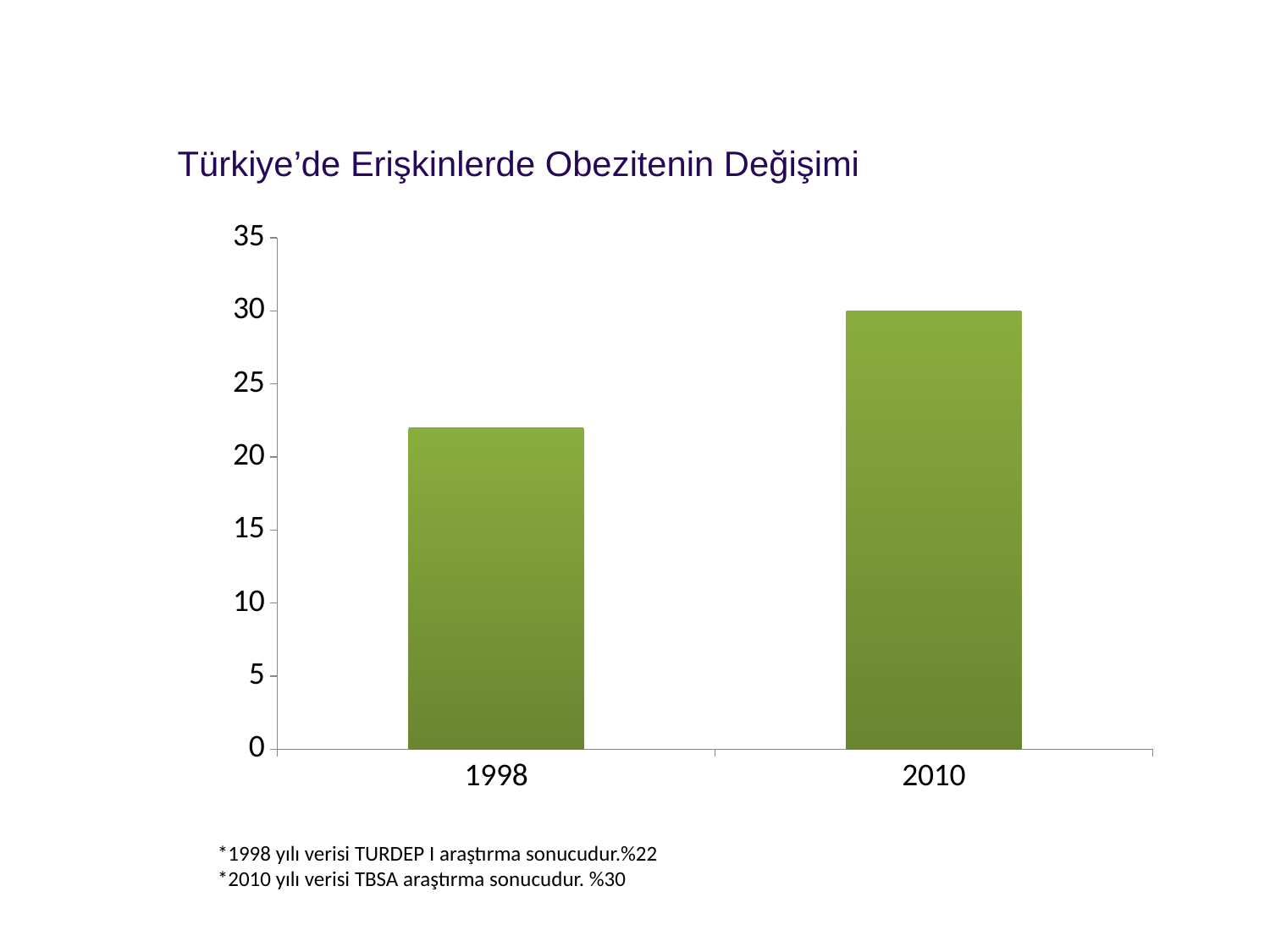
According to the footnote, what is the 1998 value? %22 How many bars are plotted in the chart? 2 Is the value for 1998 greater or less than 20? greater What is the difference between the 2010 value and the 1998 value? 8 Which is larger, the value for 1998 or the value for 2010? 2010 What is the value of the bar for 2010? 30 Which year has the lowest bar? 1998 What type of chart is shown on the slide? bar chart Which year has the highest bar? 2010 Is the value for 1998 greater or less than 25? less Do the values rise or fall from 1998 to 2010? rise What is the title of the chart? Türkiye'de Erişkinlerde Obezitenin Değişimi